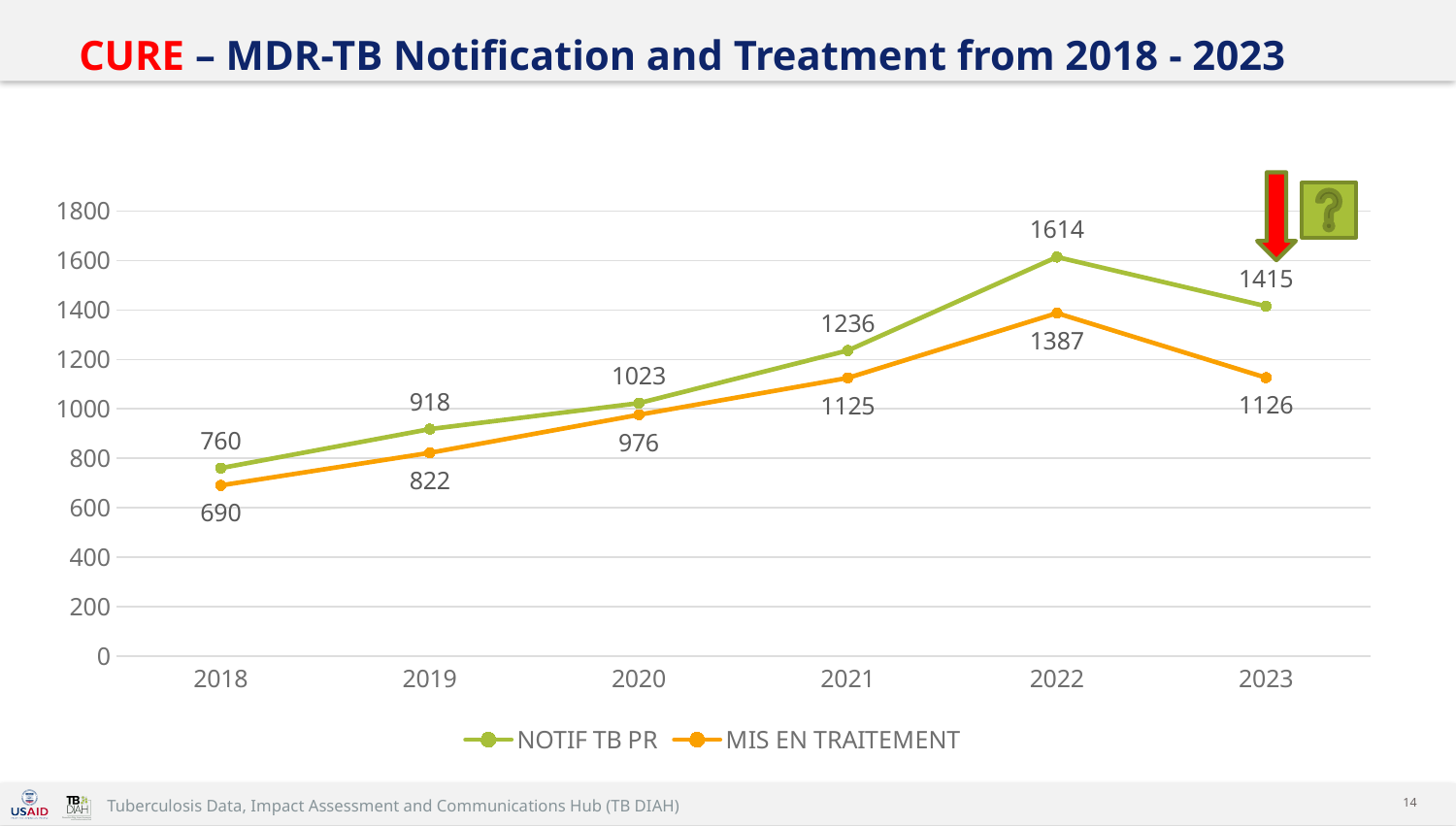
What is the MIS EN TRAITEMENT value for 2019? 822 In which year is the MIS EN TRAITEMENT value highest? 2022 What is the difference between NOTIF TB PR and MIS EN TRAITEMENT in 2023? 289 What kind of chart is shown on the slide? line chart What is the NOTIF TB PR value for 2022? 1614 Is the MIS EN TRAITEMENT value for 2020 greater or less than 1000? less How many series does the legend list? 2 In which year is the NOTIF TB PR value lowest? 2018 What is the NOTIF TB PR value for 2023? 1415 How many years are shown on the x axis? 6 Does the NOTIF TB PR series rise or fall from 2018 to 2022? rise Which is larger in 2021: NOTIF TB PR or MIS EN TRAITEMENT? NOTIF TB PR